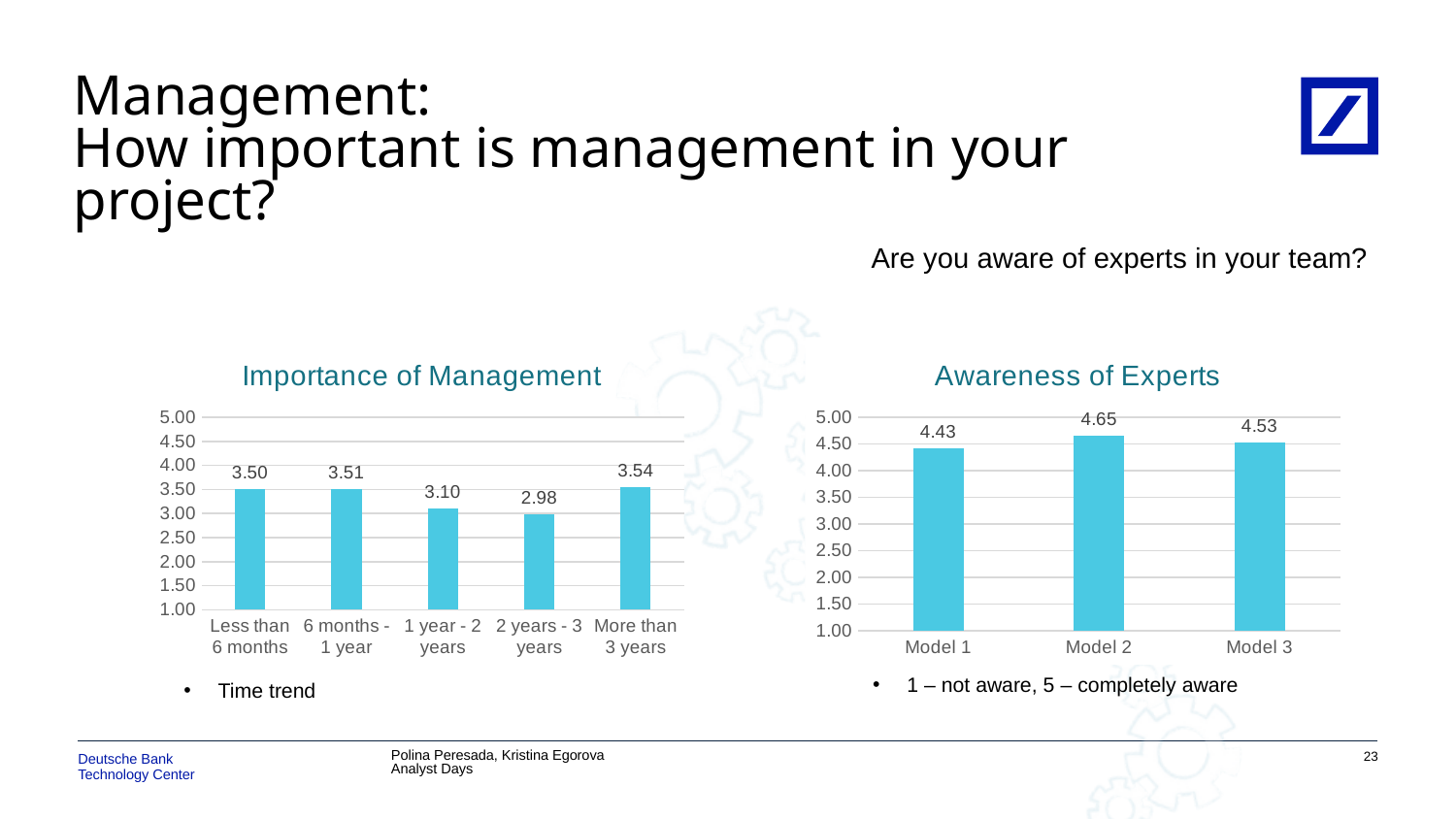
What kind of chart is the 'Awareness of Experts' chart? Bar chart In the 'Importance of Management' chart, is the value for '6 months - 1 year' greater or less than 3.00? greater What is the title of the chart on the left side of the slide? Importance of Management In the 'Awareness of Experts' chart, which model has the lowest value? Model 1 In the 'Importance of Management' chart, which category has the highest value? More than 3 years In the 'Importance of Management' chart, which category has the lowest value? 2 years - 3 years In the 'Awareness of Experts' chart, which is larger, the value for Model 3 or the value for Model 1? Model 3 In the 'Importance of Management' chart, what is the difference between the values for 'More than 3 years' and '2 years - 3 years'? 0.56 In the 'Awareness of Experts' chart, what is the difference between the values for Model 2 and Model 1? 0.22 In the 'Awareness of Experts' chart, what is the value for Model 2? 4.65 In the 'Importance of Management' chart, how many categories are shown on the x axis? 5 In the 'Importance of Management' chart, what is the value for '1 year - 2 years'? 3.10